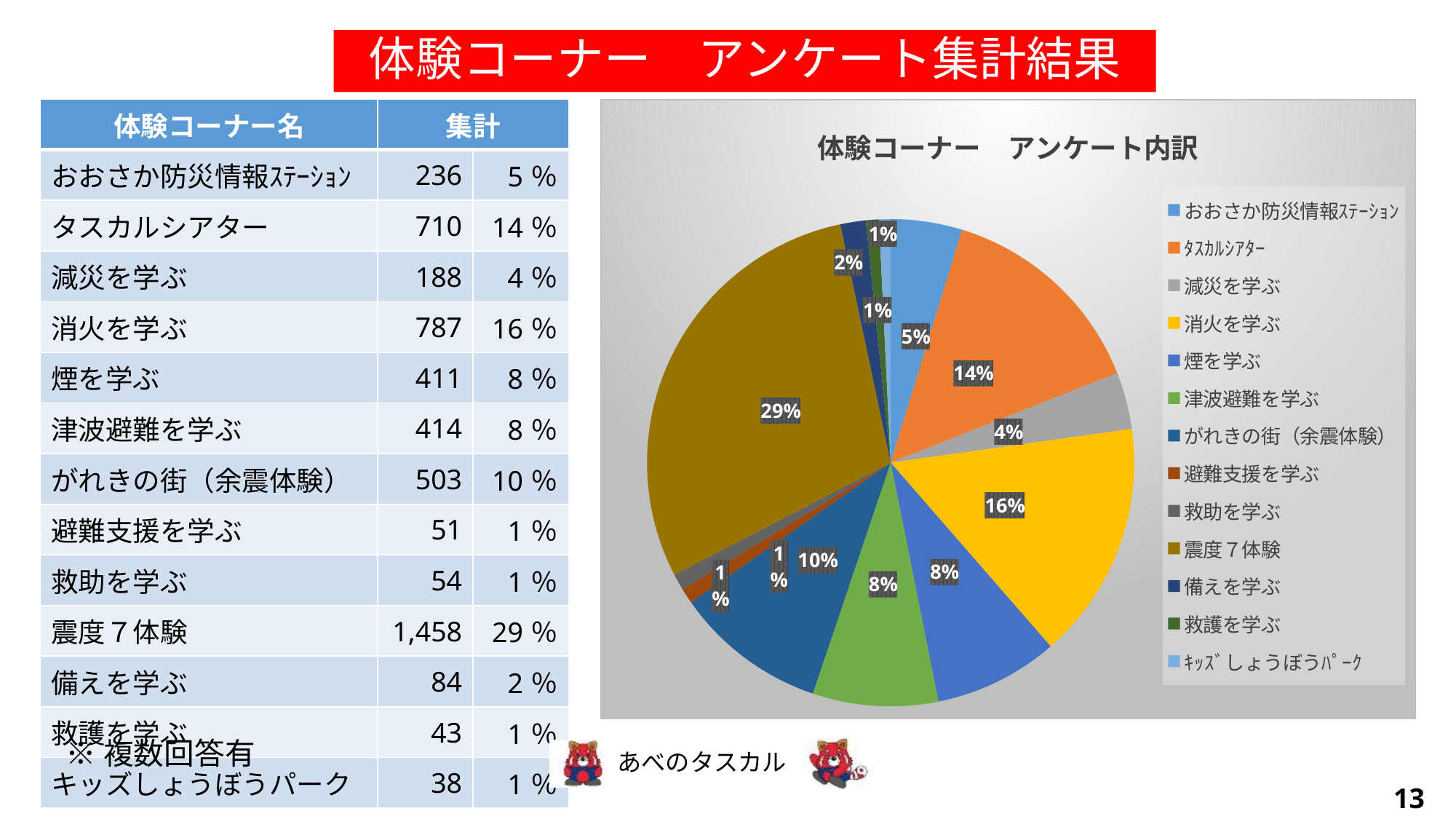
Which category has the largest slice of the pie chart? 震度７体験 What percentage is shown for 備えを学ぶ in the pie chart? 2% What percentage is shown for タスカルシアター in the pie chart? 14% What kind of chart is shown on the slide? pie chart What percentage is shown for がれきの街（余震体験） in the pie chart? 10% What share of the pie does 震度７体験 account for? 29% Which slice is larger, 消火を学ぶ or タスカルシアター? 消火を学ぶ How many slices does the pie chart have? 13 How many entries does the chart legend list? 13 What percentage is shown for 消火を学ぶ in the pie chart? 16% What is the title of the chart? 体験コーナー アンケート内訳 By how many percentage points does the 震度７体験 slice exceed the 消火を学ぶ slice? 13